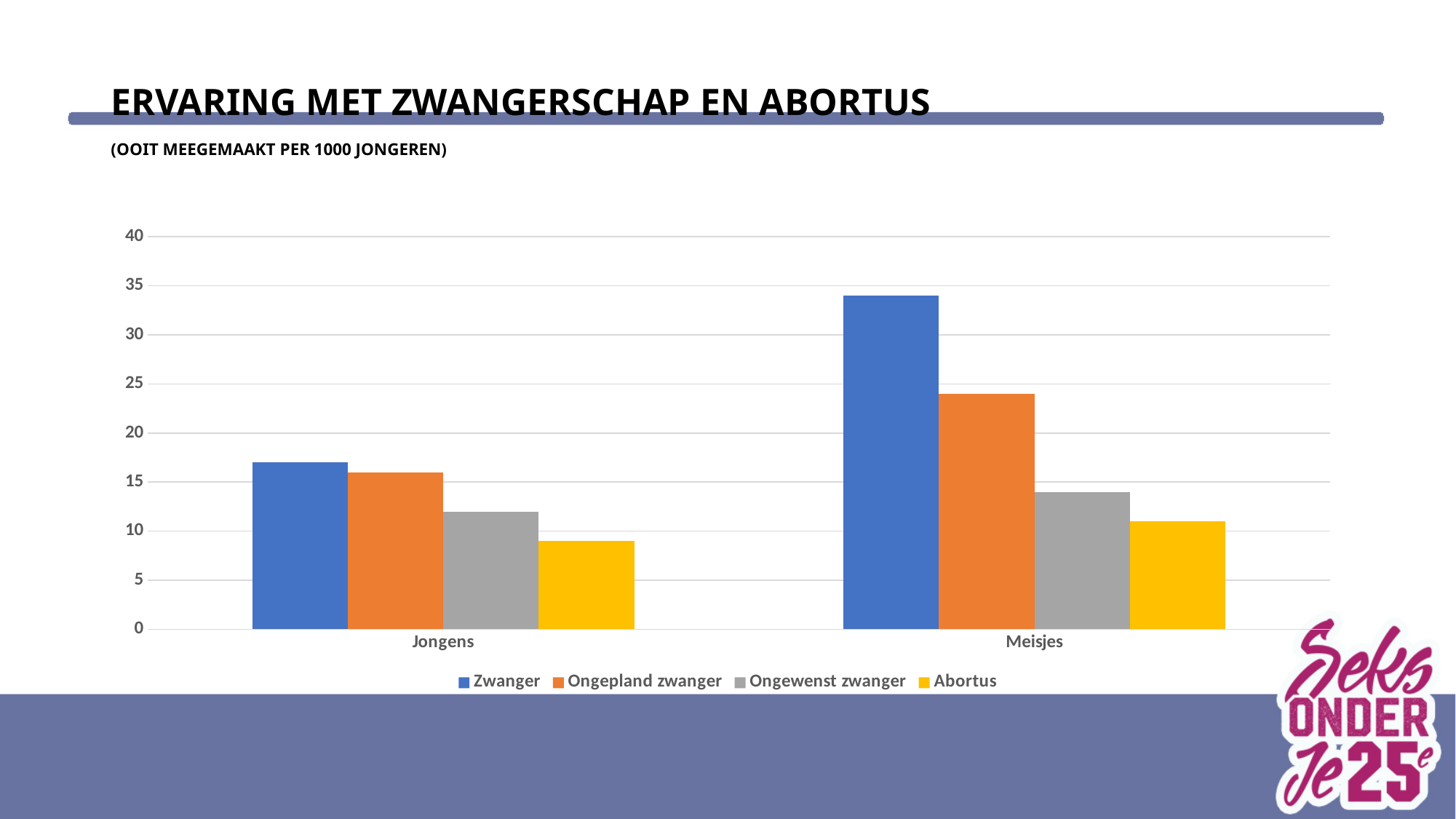
What is the title of the chart? ERVARING MET ZWANGERSCHAP EN ABORTUS Is the value for Zwanger among Meisjes greater or less than 30? greater Is the value for Abortus among Meisjes greater or less than 15? less Which is larger for Jongens, Ongepland zwanger or Ongewenst zwanger? Ongepland zwanger Which series has the highest value for Meisjes? Zwanger What kind of chart is shown on the slide? bar chart Which series has the lowest value for Jongens? Abortus Which series has the lowest value for Meisjes? Abortus Which is larger, the Zwanger value for Jongens or for Meisjes? Meisjes Is the value for Ongepland zwanger among Meisjes greater or less than 20? greater How many categories are shown on the x axis? 2 How many series does the legend list? 4